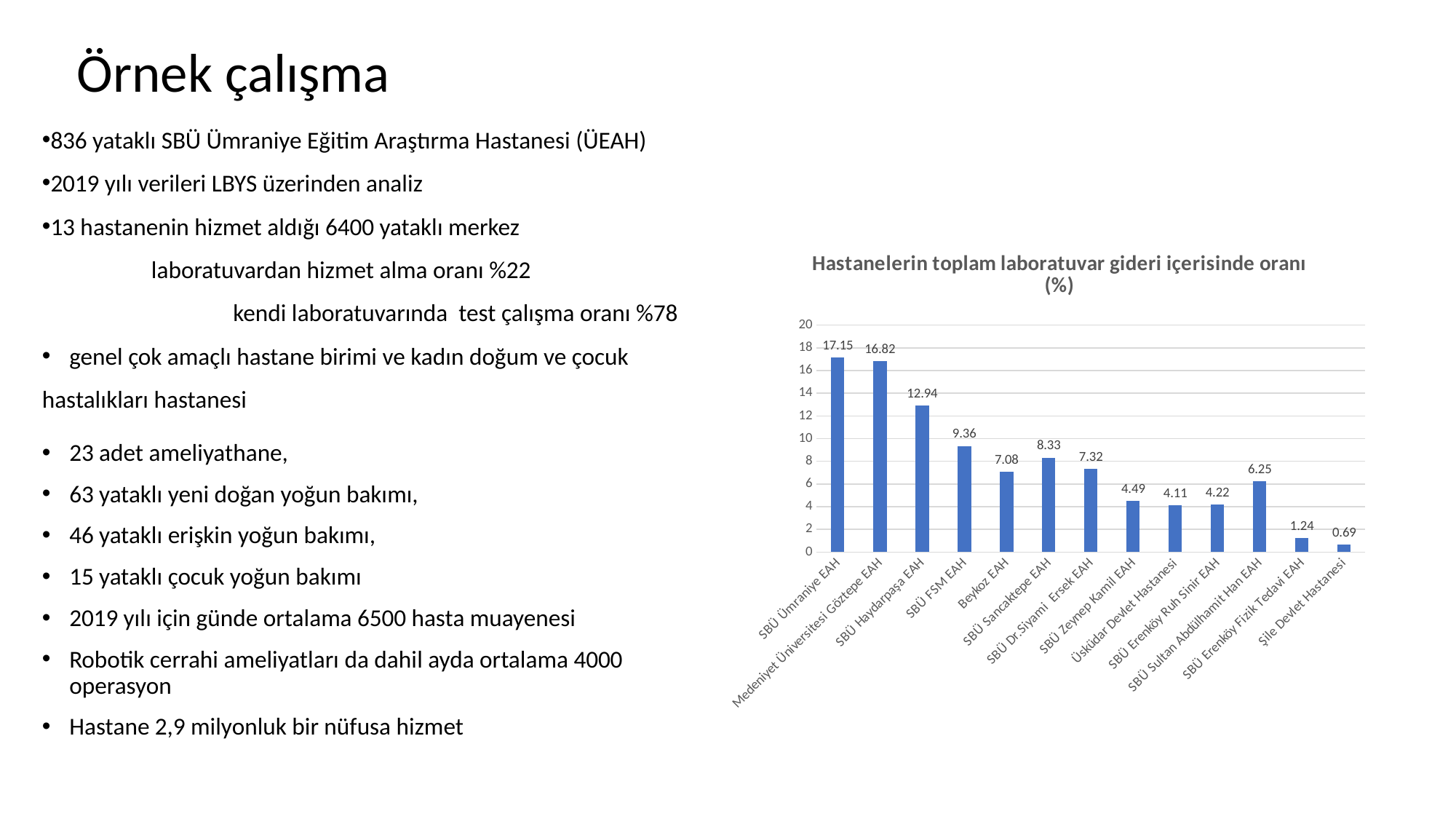
Which is larger, the value for SBÜ FSM EAH or the value for SBÜ Sancaktepe EAH? SBÜ FSM EAH What is the value for SBÜ Haydarpaşa EAH? 12.94 Which hospital has the highest value? SBÜ Ümraniye EAH What is the value for Şile Devlet Hastanesi? 0.69 What is the title of the chart? Hastanelerin toplam laboratuvar gideri içerisinde oranı (%) What kind of chart is shown on the slide? bar chart What is the difference between the values for SBÜ Zeynep Kamil EAH and Üsküdar Devlet Hastanesi? 0.38 Is the value for SBÜ Sultan Abdülhamit Han EAH greater or less than 8? less What is the value for SBÜ Sancaktepe EAH? 8.33 How many hospitals are shown on the chart? 13 What is the difference between the values for SBÜ Ümraniye EAH and Medeniyet Üniversitesi Göztepe EAH? 0.33 Which hospital has the lowest value? Şile Devlet Hastanesi